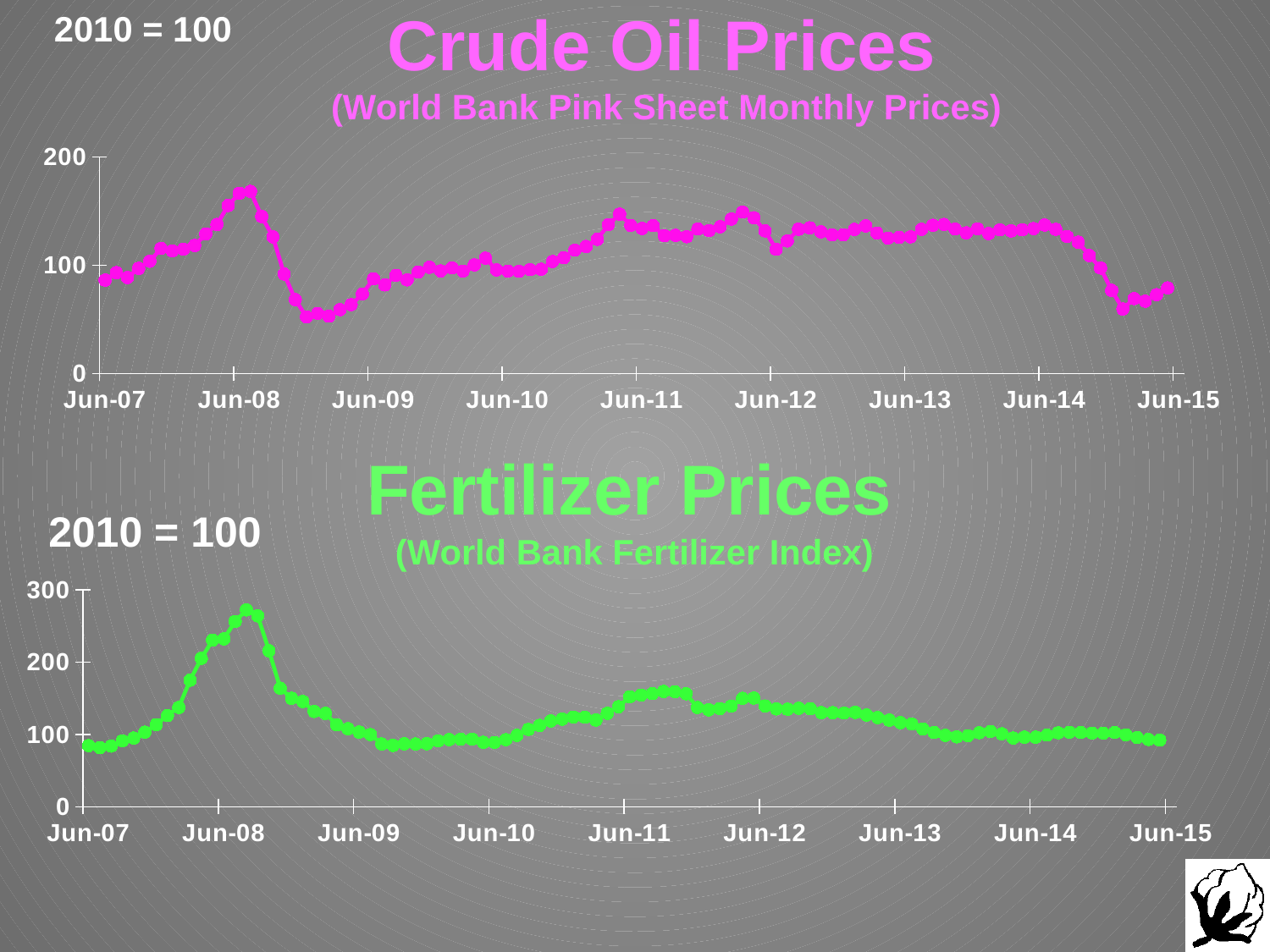
In the Fertilizer Prices chart, is the value at Jun-11 greater or less than 100? greater How many year labels are shown on the x axis of the Crude Oil Prices chart? 9 What is the subtitle of the Fertilizer Prices chart? (World Bank Fertilizer Index) In the Fertilizer Prices chart, is the peak value greater or less than 200? greater What kind of chart is the Crude Oil Prices chart? line chart In the Crude Oil Prices chart, is the value at Jun-08 greater or less than 100? greater In the Fertilizer Prices chart, around which x-axis label does the line reach its highest point? Jun-08 What kind of chart is the Fertilizer Prices chart? line chart In the Fertilizer Prices chart, do values rise or fall between Jun-12 and Jun-15? fall In the Crude Oil Prices chart, around which x-axis label does the line reach its highest point? Jun-08